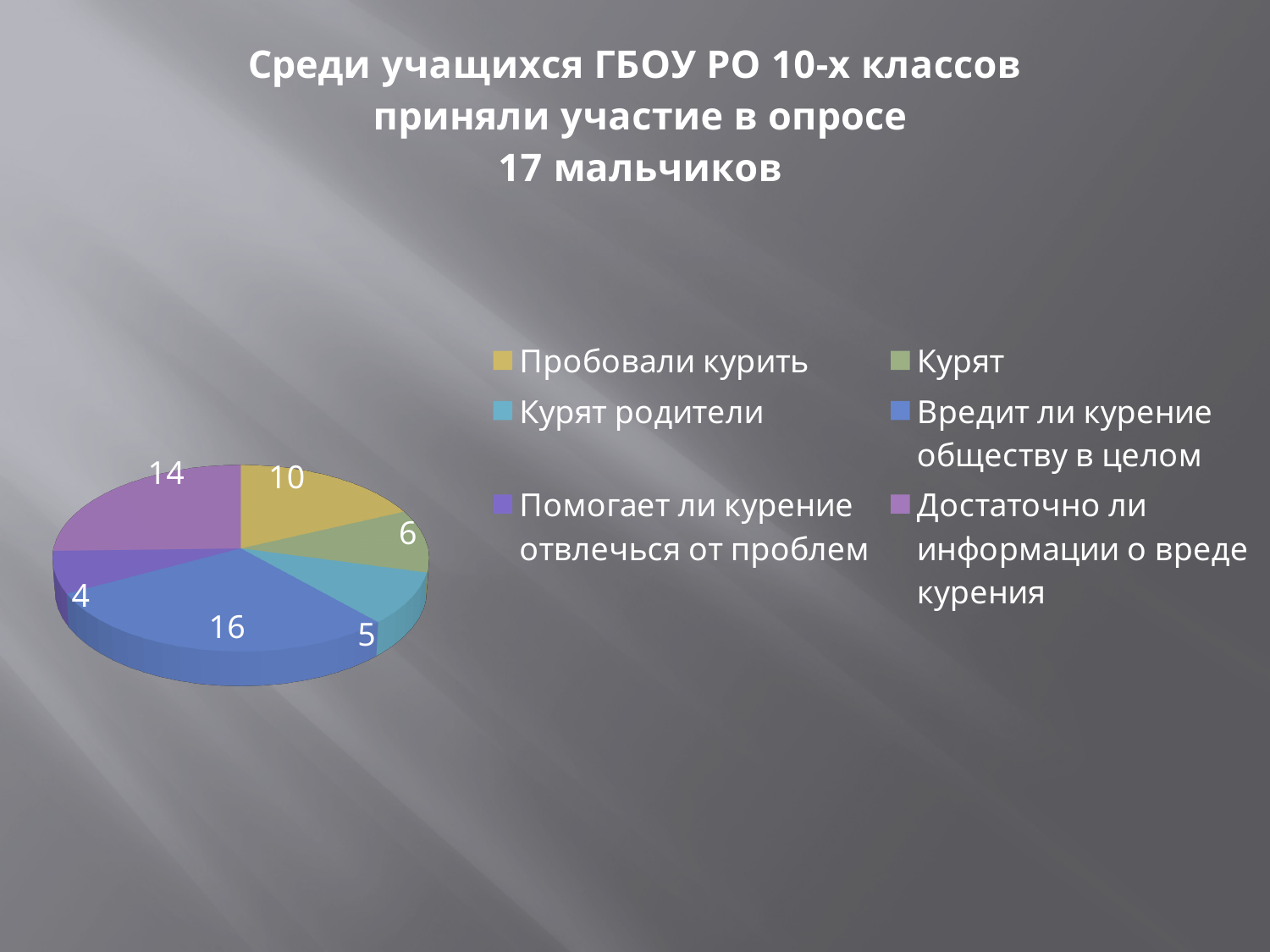
Which is larger: the value for "Пробовали курить" or the value for "Курят"? Пробовали курить What is the value for "Вредит ли курение обществу в целом"? 16 What is the value for "Курят"? 6 How many slices does the pie chart have? 6 What is the value for "Помогает ли курение отвлечься от проблем"? 4 Which category has the smallest slice of the pie? Помогает ли курение отвлечься от проблем What is the value for "Курят родители"? 5 What is the difference between the values for "Вредит ли курение обществу в целом" and "Достаточно ли информации о вреде курения"? 2 Which category has the largest slice of the pie? Вредит ли курение обществу в целом What is the value for "Достаточно ли информации о вреде курения"? 14 What is the value for "Пробовали курить"? 10 What kind of chart is shown on the slide? pie chart